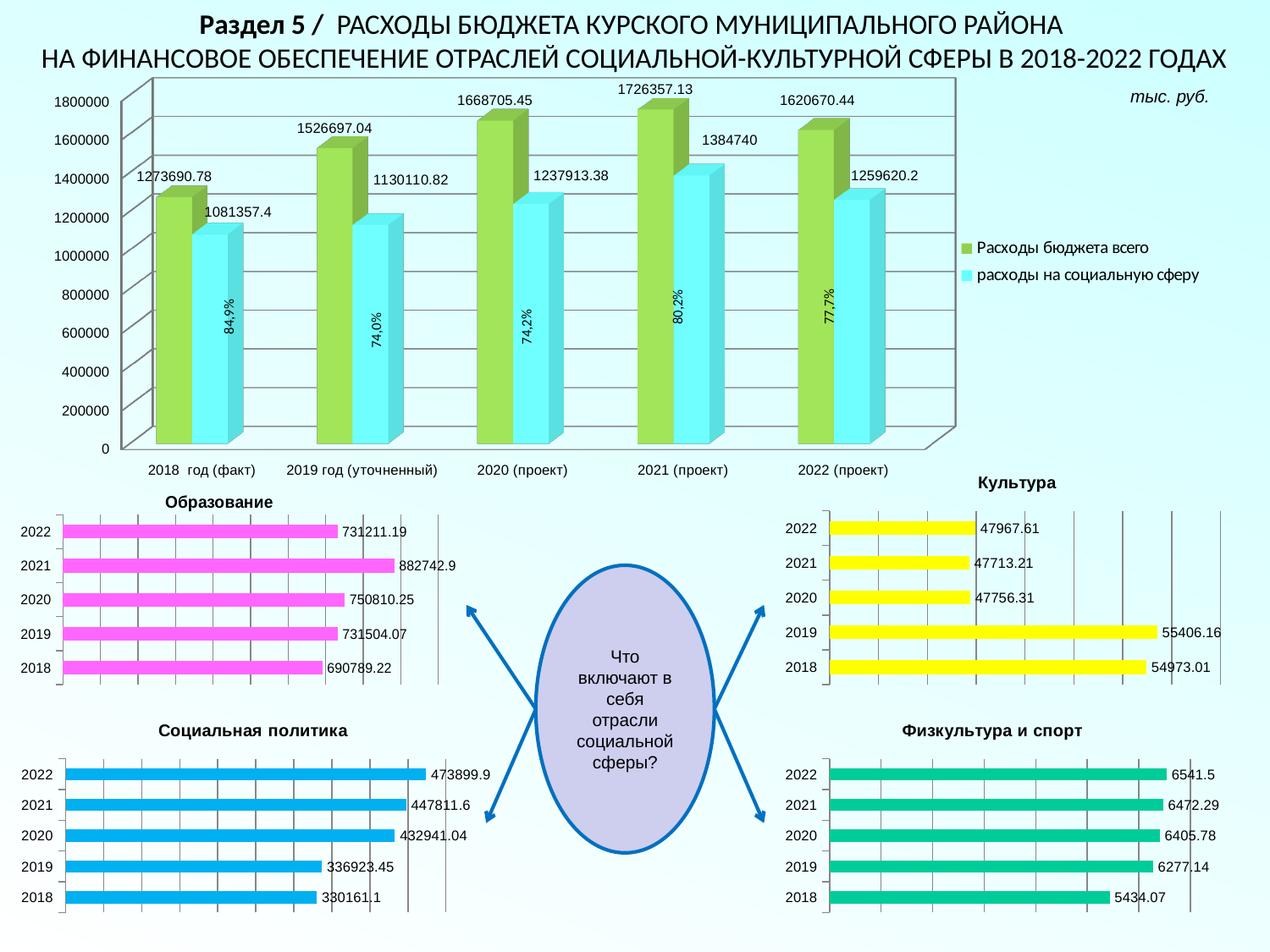
On the top chart, what is the value of 'расходы на социальную сферу' for 2019 год (уточненный)? 1130110.82 How many series does the legend of the top chart list? 2 On the top chart, what is the value of 'Расходы бюджета всего' for 2021 (проект)? 1726357.13 On the 'Образование' chart, which year has the highest value? 2021 On the 'Культура' chart, what is the value for 2018? 54973.01 How many years are shown on the 'Социальная политика' chart? 5 What kind of chart is the 'Образование' chart? bar chart On the 'Социальная политика' chart, do the values rise or fall from 2018 to 2022? rise On the 'Образование' chart, which is larger, the value for 2020 or the value for 2019? 2020 On the top chart, what is the difference between 'Расходы бюджета всего' and 'расходы на социальную сферу' for 2021 (проект)? 341617.13 On the 'Физкультура и спорт' chart, what is the value for 2018? 5434.07 On the top chart, in which year is 'Расходы бюджета всего' the highest? 2021 (проект)